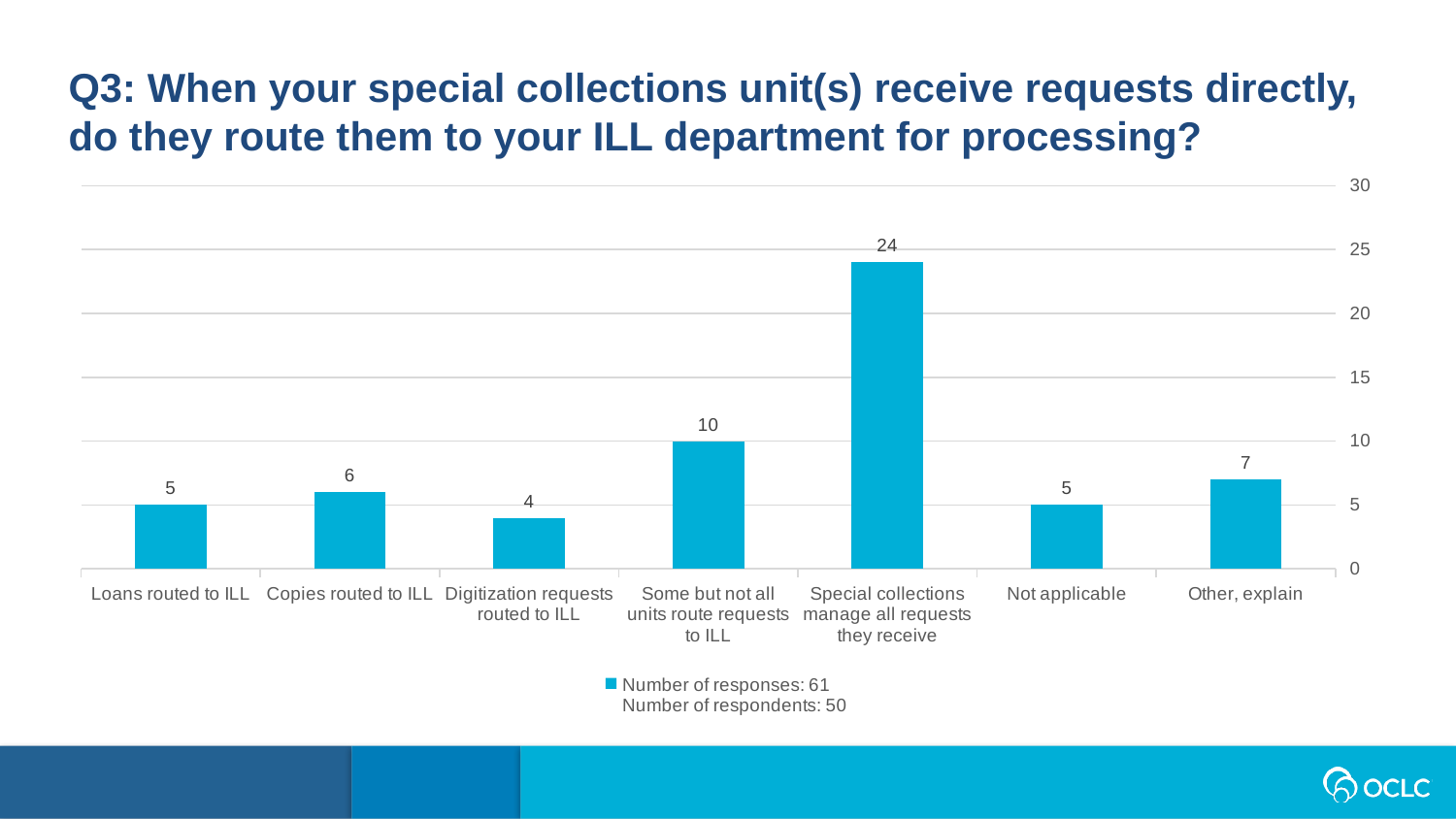
What is the value for "Special collections manage all requests they receive"? 24 What is the difference between "Special collections manage all requests they receive" and "Some but not all units route requests to ILL"? 14 Which category has the lowest value? Digitization requests routed to ILL What is the value for "Digitization requests routed to ILL"? 4 Which category has the highest value? Special collections manage all requests they receive What kind of chart is shown on the slide? bar chart Is the value for "Special collections manage all requests they receive" greater or less than 20? greater What is the value for "Some but not all units route requests to ILL"? 10 How many categories are shown on the x axis? 7 What does the legend entry say? Number of responses: 61 Number of respondents: 50 Which is larger: "Copies routed to ILL" or "Other, explain"? Other, explain What is the value for "Other, explain"? 7